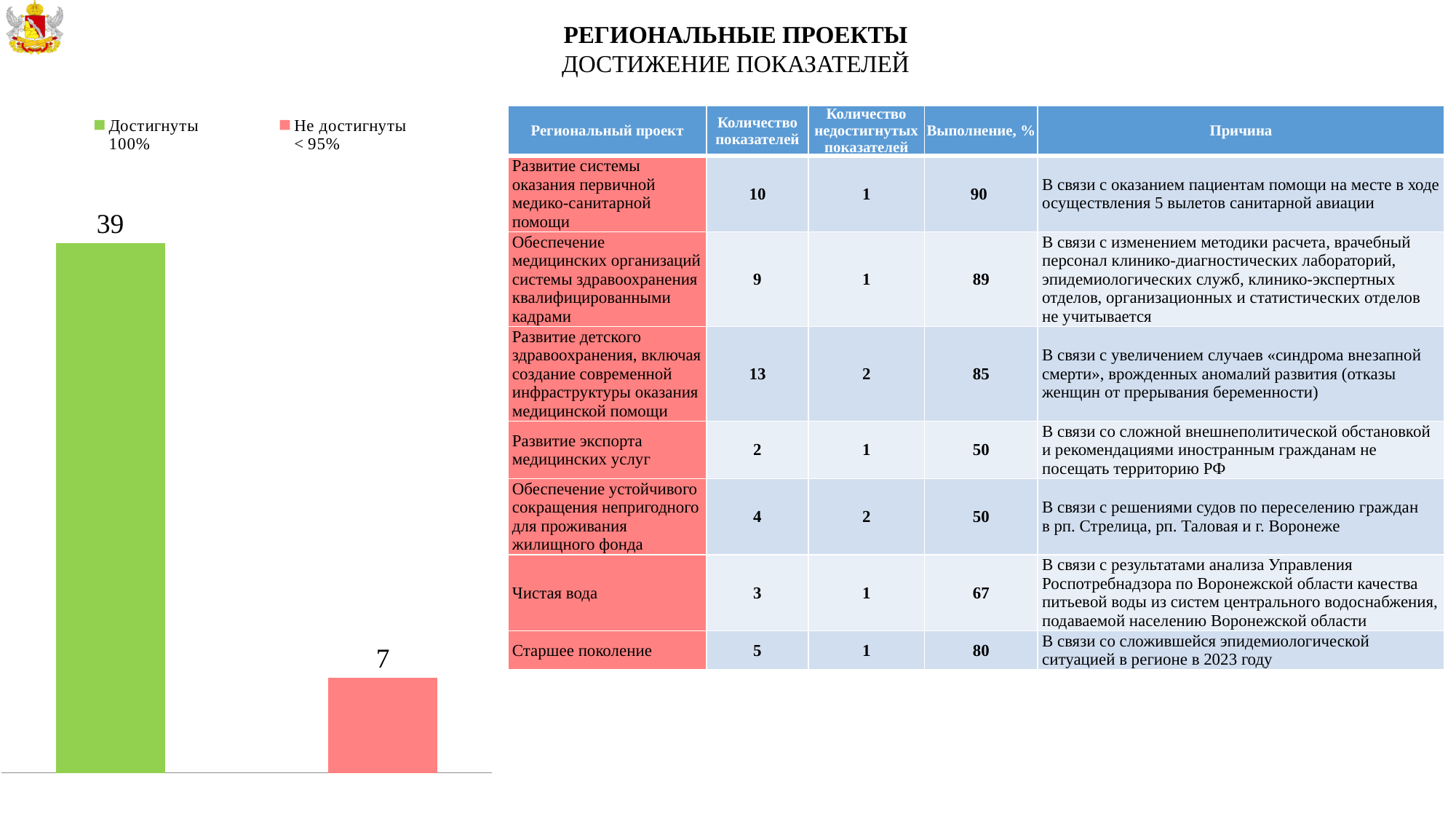
What kind of chart is shown on the left of the slide? Bar chart Which category has the highest bar in the chart? Достигнуты 100% How many bars are plotted in the chart? 2 What is the difference between the "Достигнуты 100%" bar and the "Не достигнуты < 95%" bar? 32 What is the value of the bar for "Не достигнуты < 95%"? 7 Which is larger: the value for "Достигнуты 100%" or the value for "Не достигнуты < 95%"? Достигнуты 100% Which category has the lowest bar in the chart? Не достигнуты < 95% What is the value of the bar for "Достигнуты 100%"? 39 What colour is the bar for "Достигнуты 100%"? Green How many entries does the chart legend list? 2 What is the total of the two bars in the chart? 46 What colour is the bar for "Не достигнуты < 95%"? Red